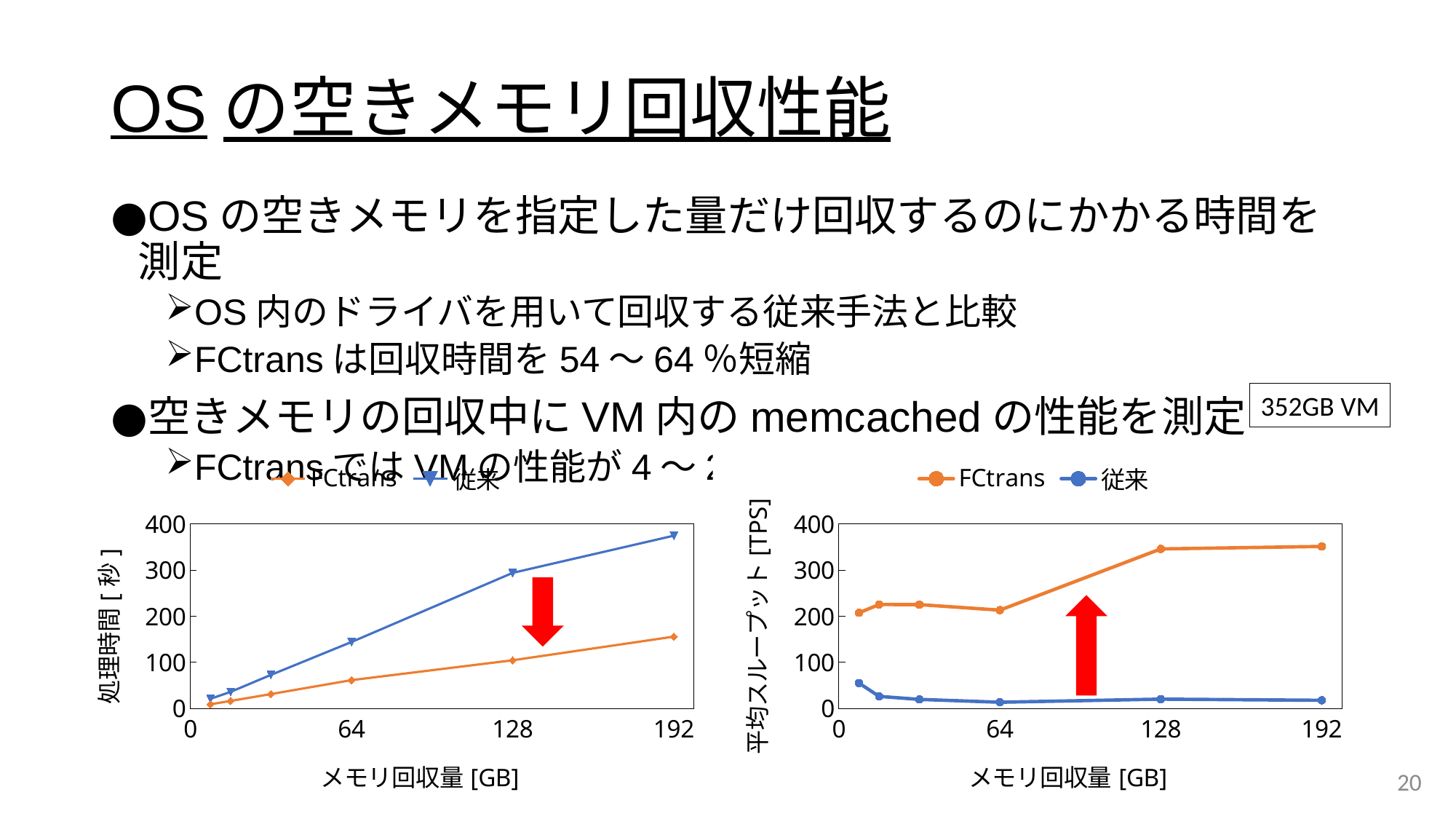
In the left chart (処理時間 [秒]), does the 従来 series rise or fall as メモリ回収量 increases? rise In the right chart (平均スループット [TPS]), what are the two series named in the legend? FCtrans and 従来 What kind of chart is the left chart (処理時間 [秒])? line chart In the right chart (平均スループット [TPS]), is the value for FCtrans at 192 GB greater or less than 300? greater In the left chart (処理時間 [秒]), which series has the larger value at 192 GB, FCtrans or 従来? 従来 In the right chart (平均スループット [TPS]), is the value for 従来 at 192 GB greater or less than 100? less In the left chart (処理時間 [秒]), is the value for FCtrans at 192 GB greater or less than 200? less In the left chart (処理時間 [秒]), how many series does the legend list? 2 In the right chart (平均スループット [TPS]), which series has the larger value at 128 GB, FCtrans or 従来? FCtrans What kind of chart is the right chart (平均スループット [TPS])? line chart